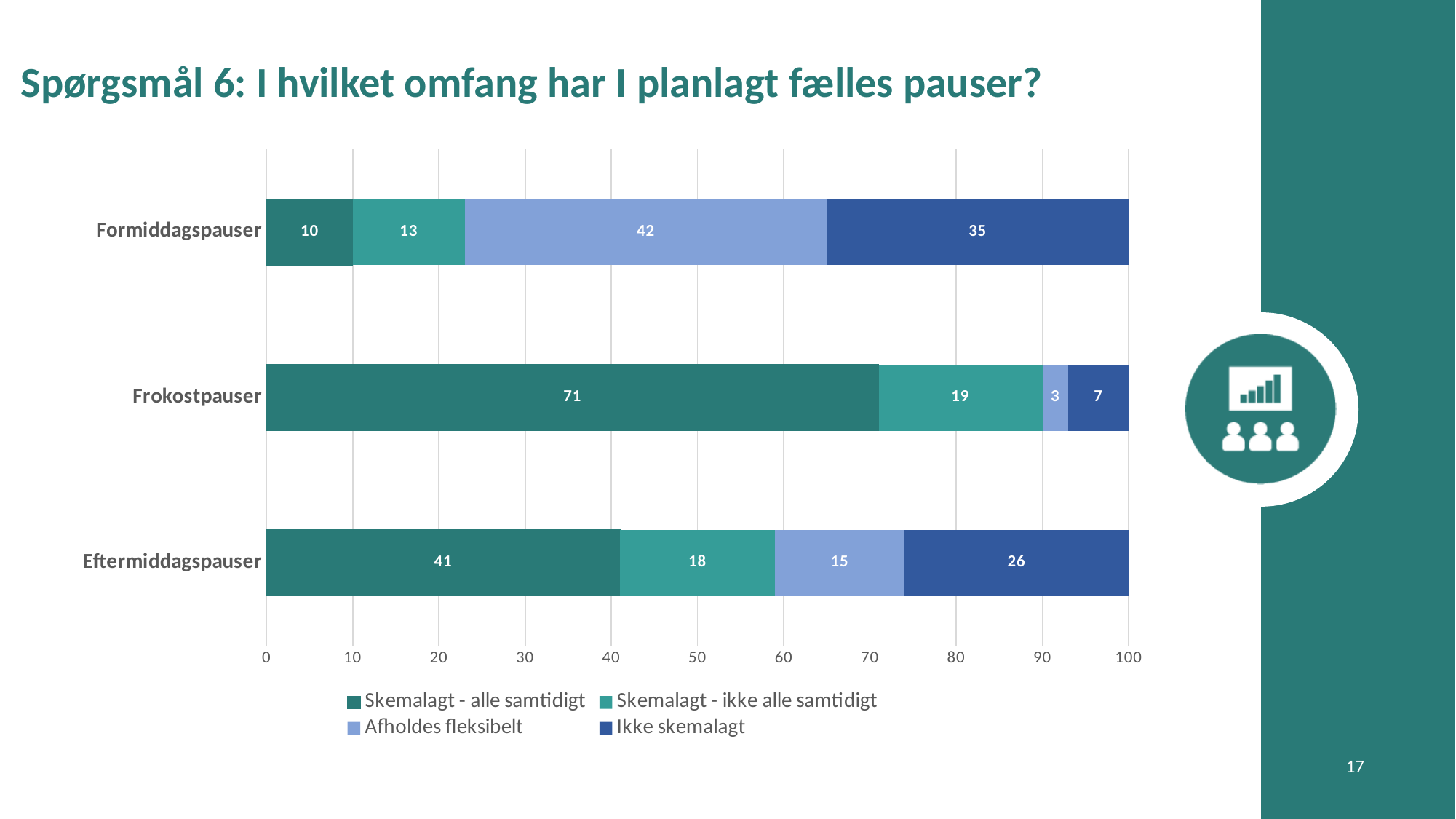
What is the difference between the 'Ikke skemalagt' values for Formiddagspauser and Eftermiddagspauser? 9 What kind of chart is shown on the slide? Stacked bar chart How many series does the legend list? 4 What is the value for 'Ikke skemalagt' for Eftermiddagspauser? 26 What is the value for 'Skemalagt - ikke alle samtidigt' for Frokostpauser? 19 Which category has the lowest value for 'Ikke skemalagt'? Frokostpauser How many categories are shown on the y axis? 3 What is the value for 'Skemalagt - alle samtidigt' for Frokostpauser? 71 Which category has the highest value for 'Skemalagt - alle samtidigt'? Frokostpauser What is the value for 'Afholdes fleksibelt' for Formiddagspauser? 42 Which is larger: 'Afholdes fleksibelt' for Formiddagspauser or for Eftermiddagspauser? Formiddagspauser What is the total of the stacked bar for Eftermiddagspauser? 100